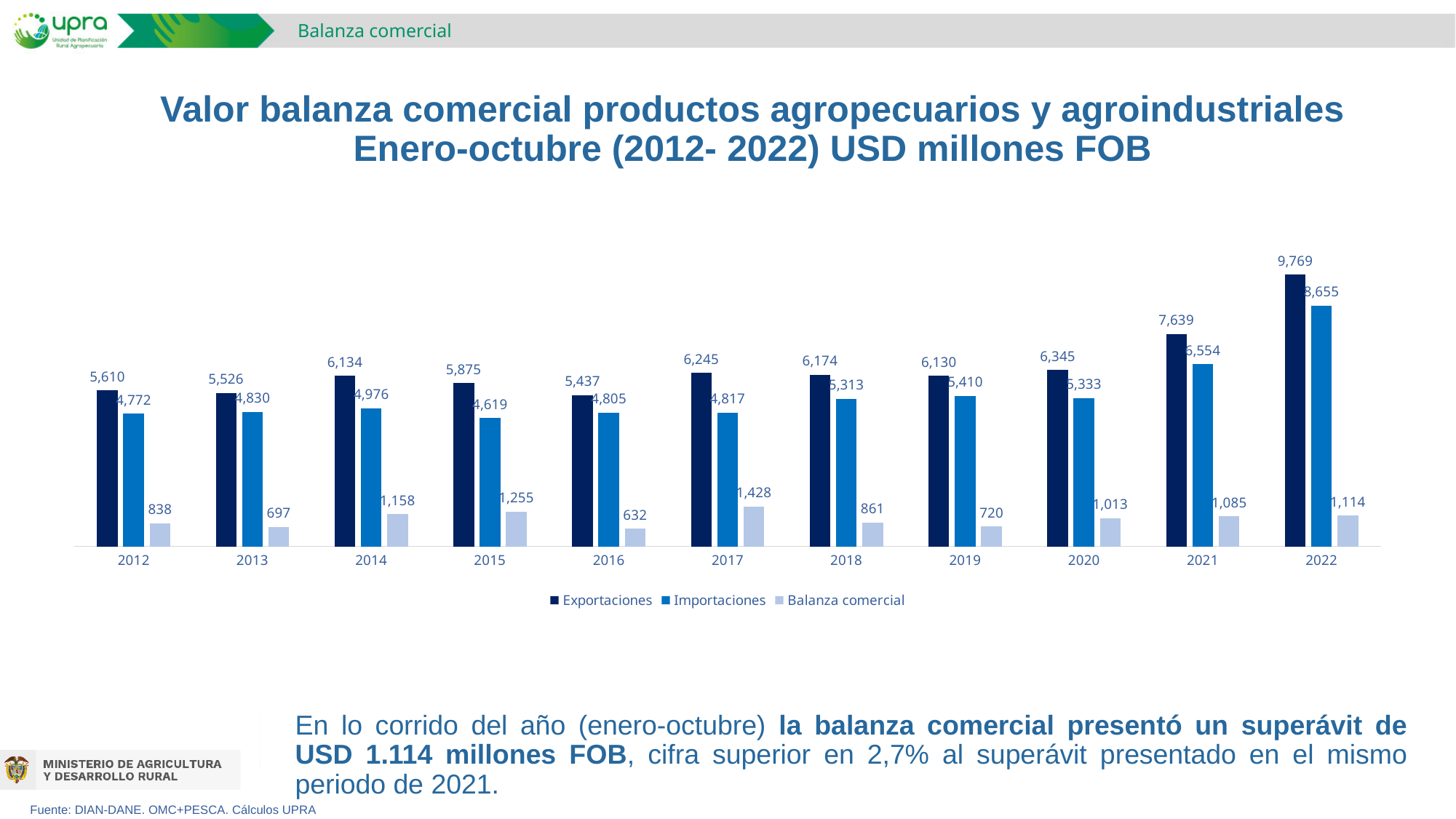
How many series does the legend list? 3 What is the value of Importaciones for 2021? 6,554 What is the value of Balanza comercial for 2017? 1,428 What is the difference between Exportaciones and Importaciones in 2022? 1,114 What is the value of Importaciones for 2015? 4,619 Which year has the lowest Balanza comercial value? 2016 What kind of chart is shown on the slide? Bar chart Which year has the lowest Exportaciones value? 2016 Which is larger, the Balanza comercial for 2020 or for 2021? 2021 Which year has the highest Balanza comercial value? 2017 How many years are shown on the x axis? 11 What is the value of Exportaciones for 2022? 9,769